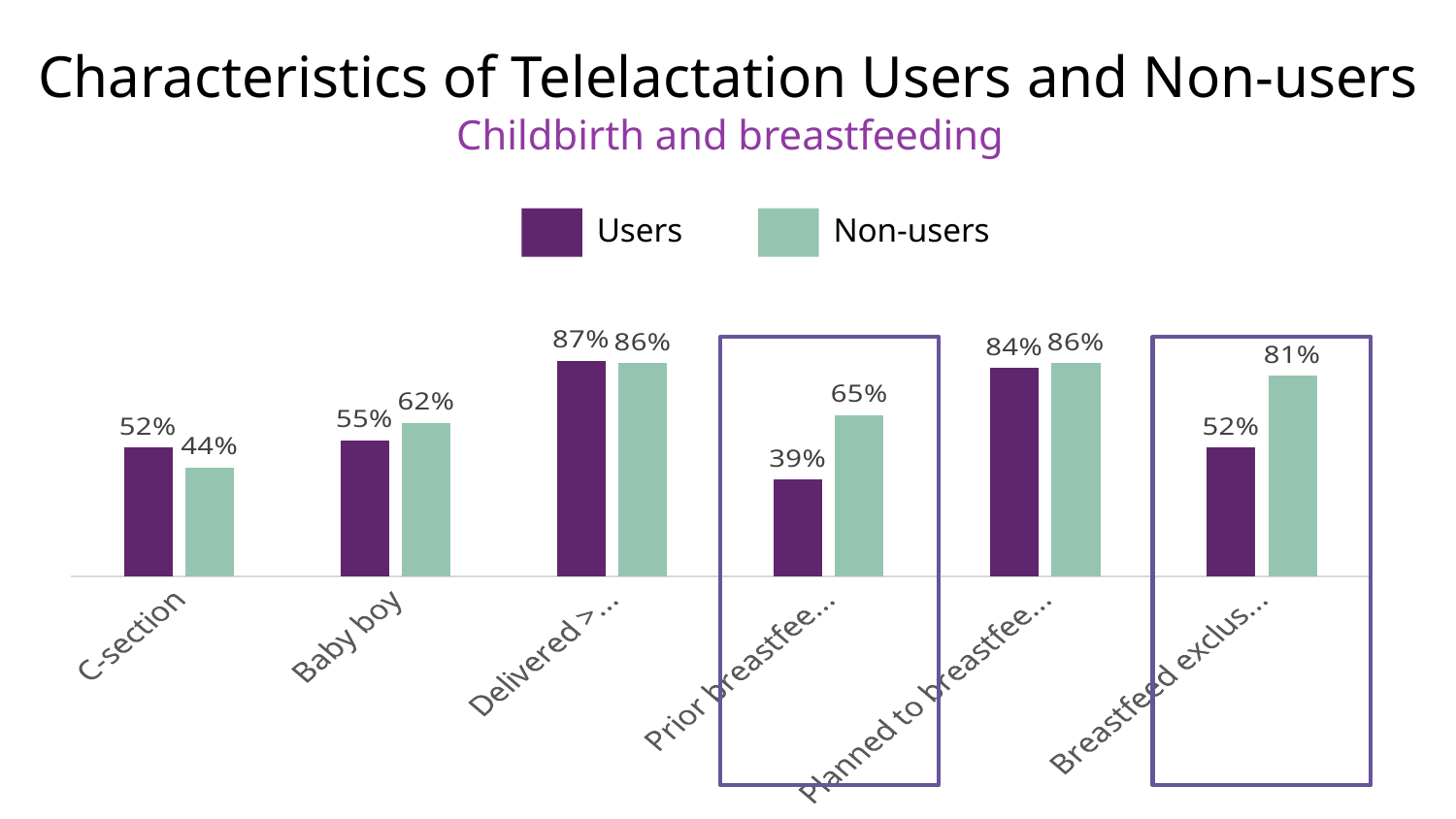
What is the highest value shown for the Users series? 87% What is the lowest value shown for the Users series? 39% What is the value for Users in the C-section category? 52% In the Baby boy category, which series has the larger value, Users or Non-users? Non-users What kind of chart is shown on the slide? Bar chart What is the value for Non-users in the category whose label begins 'Prior breastfee'? 65% What colour represents the Users series in the legend? Purple What is the difference between the Non-users and Users values in the category whose label begins 'Breastfeed exclus'? 29 percentage points How many categories are shown on the x axis? 6 What is the difference between the Users and Non-users values in the C-section category? 8 percentage points How many series does the legend list? 2 What is the value for Non-users in the Baby boy category? 62%